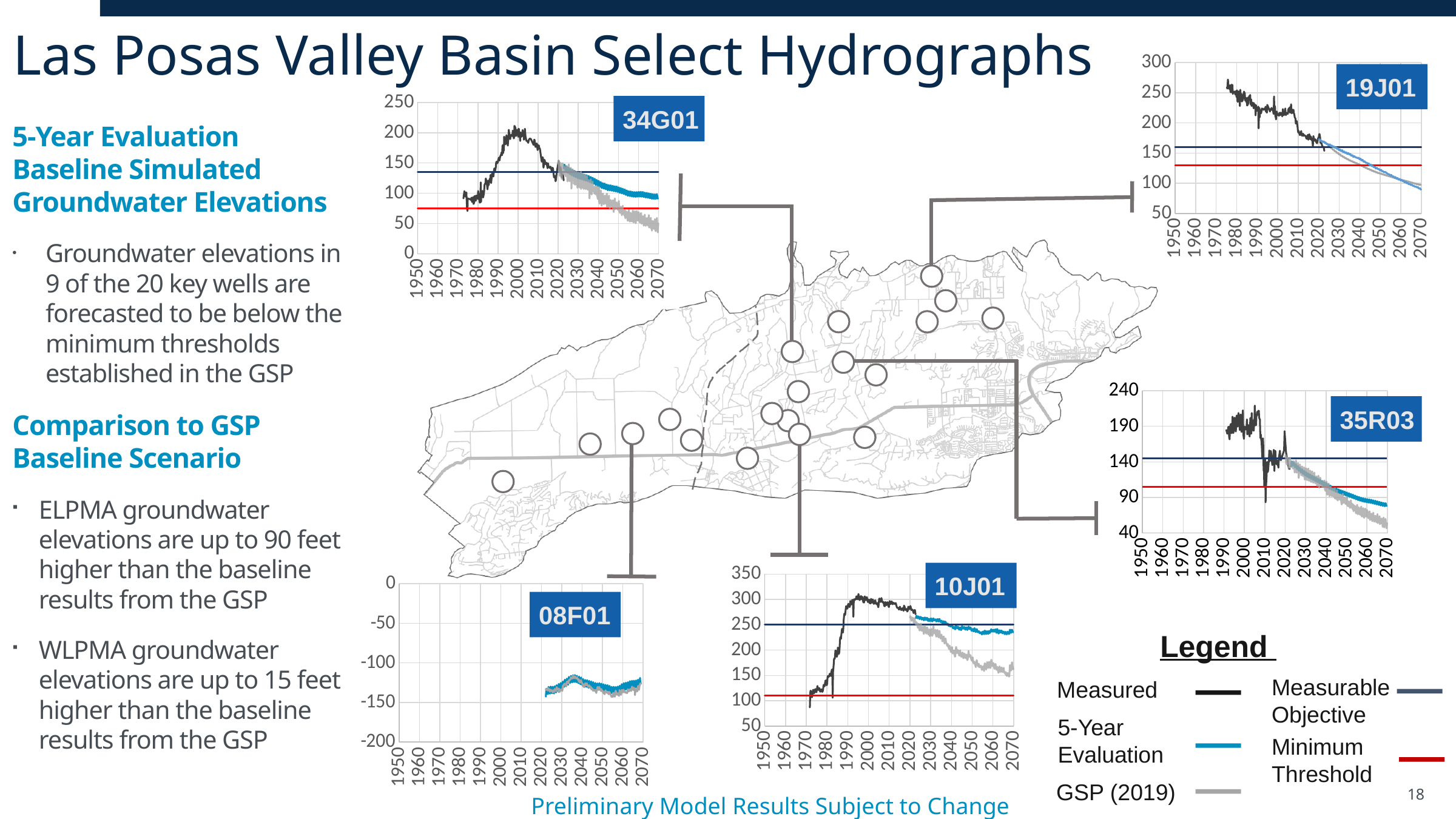
In the 34G01 chart, is the peak Measured value around 2000 greater or less than 150? greater How many hydrograph charts are shown on the slide? 5 In the 19J01 chart, does the Measured line rise or fall from 1975 to 2020? fall How many entries does the Legend list? 5 According to the Legend, what colour is the Minimum Threshold line? red In the 08F01 chart, is the 5-Year Evaluation value in 2040 greater or less than -100? less In the 34G01 chart, is the 5-Year Evaluation value in 2070 greater or less than 150? less What kind of chart is the 34G01 hydrograph? line chart In the 10J01 chart, which is higher in 2070, the 5-Year Evaluation line or the GSP (2019) line? 5-Year Evaluation